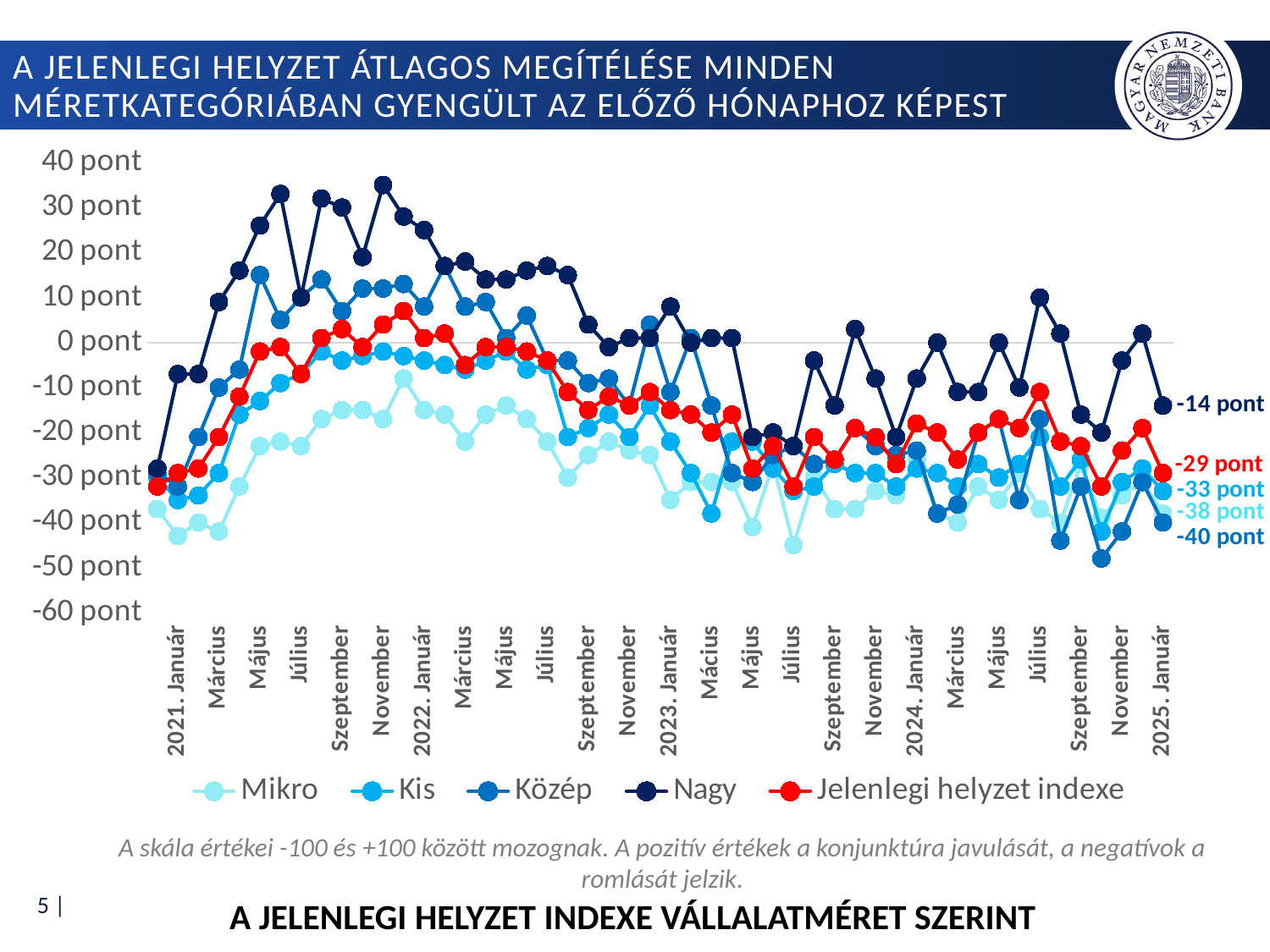
At the last data point (2025. Január), which is larger: the Kis value or the Mikro value? Kis Which series has the highest value at the last data point (2025. Január)? Nagy What is the value of the Jelenlegi helyzet indexe series at the last data point (2025. Január)? -29 pont How many series does the legend list? 5 What is the value of the Kis series at the last data point (2025. Január)? -33 pont Is the value of the Nagy series in November 2021 greater or less than 30 pont? greater What is the value of the Nagy series at the last data point (2025. Január)? -14 pont What is the value of the Közép series at the last data point (2025. Január)? -40 pont What is the value of the Mikro series at the last data point (2025. Január)? -38 pont Which series has the lowest value at the last data point (2025. Január)? Közép What is the difference between the Nagy and Közép values at the last data point (2025. Január)? 26 pont What kind of chart is shown on the slide? line chart